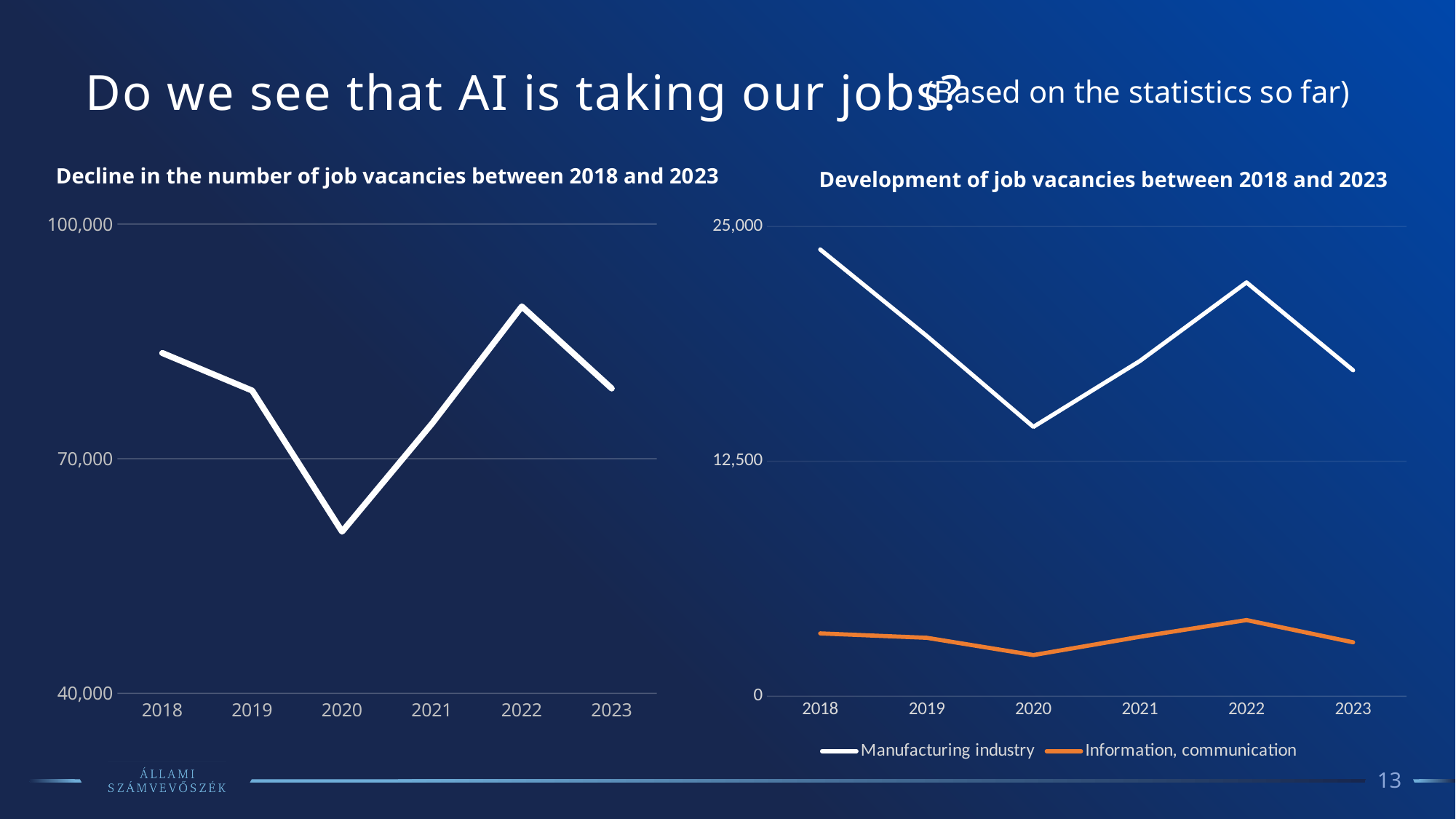
In the right chart, which year has the lowest value for Manufacturing industry? 2020 How many series does the legend of the right chart list? 2 In the right chart, which series is drawn in orange? Information, communication In the left chart, is the value for 2020 greater or less than 70,000? less In the left chart, which year has the lowest number of job vacancies? 2020 What type of chart is the left chart titled "Decline in the number of job vacancies between 2018 and 2023"? Line chart In the right chart, which series is larger in 2020, Manufacturing industry or Information, communication? Manufacturing industry In the left chart, which year has the highest number of job vacancies? 2022 In the right chart, is the Manufacturing industry value for 2018 greater or less than 12,500? greater How many years are plotted on the x axis of the left chart? 6 In the right chart, which year has the highest value for Manufacturing industry? 2018 In the left chart, is the value for 2022 greater or less than 70,000? greater